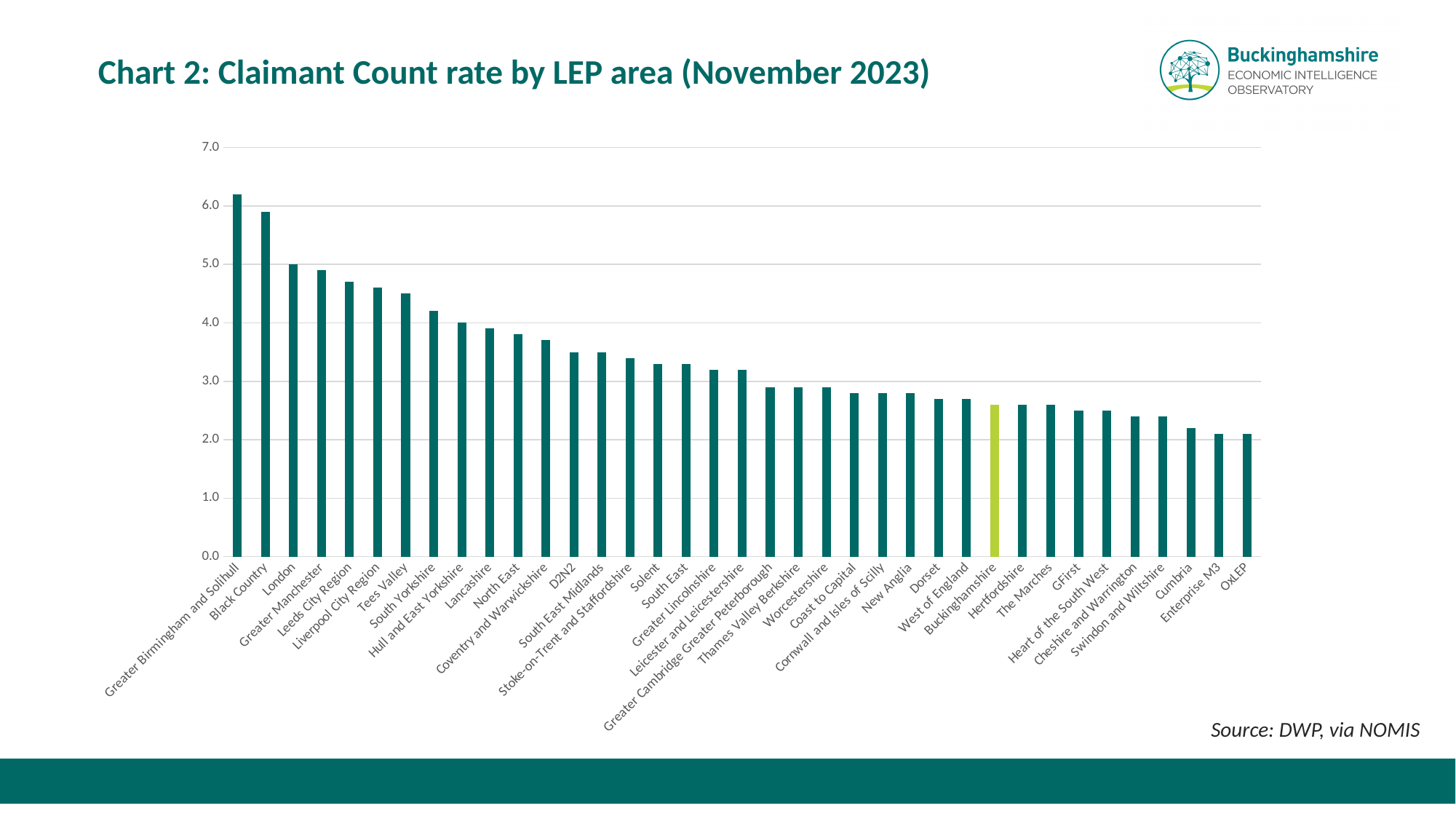
Do the values rise or fall moving from left to right along the x axis? Fall Is the value for Solent greater or less than 3.0? greater Is the value for Tees Valley greater or less than 4.0? greater What kind of chart is shown on the slide? Bar chart Is the value for Black Country greater or less than 5.0? greater Which LEP area's bar is highlighted in a different colour (green) from the others? Buckinghamshire How many LEP areas are plotted on the chart? 37 Which has the larger Claimant Count rate, London or Buckinghamshire? London Which LEP area has the highest Claimant Count rate? Greater Birmingham and Solihull Which has the larger Claimant Count rate, Black Country or Tees Valley? Black Country